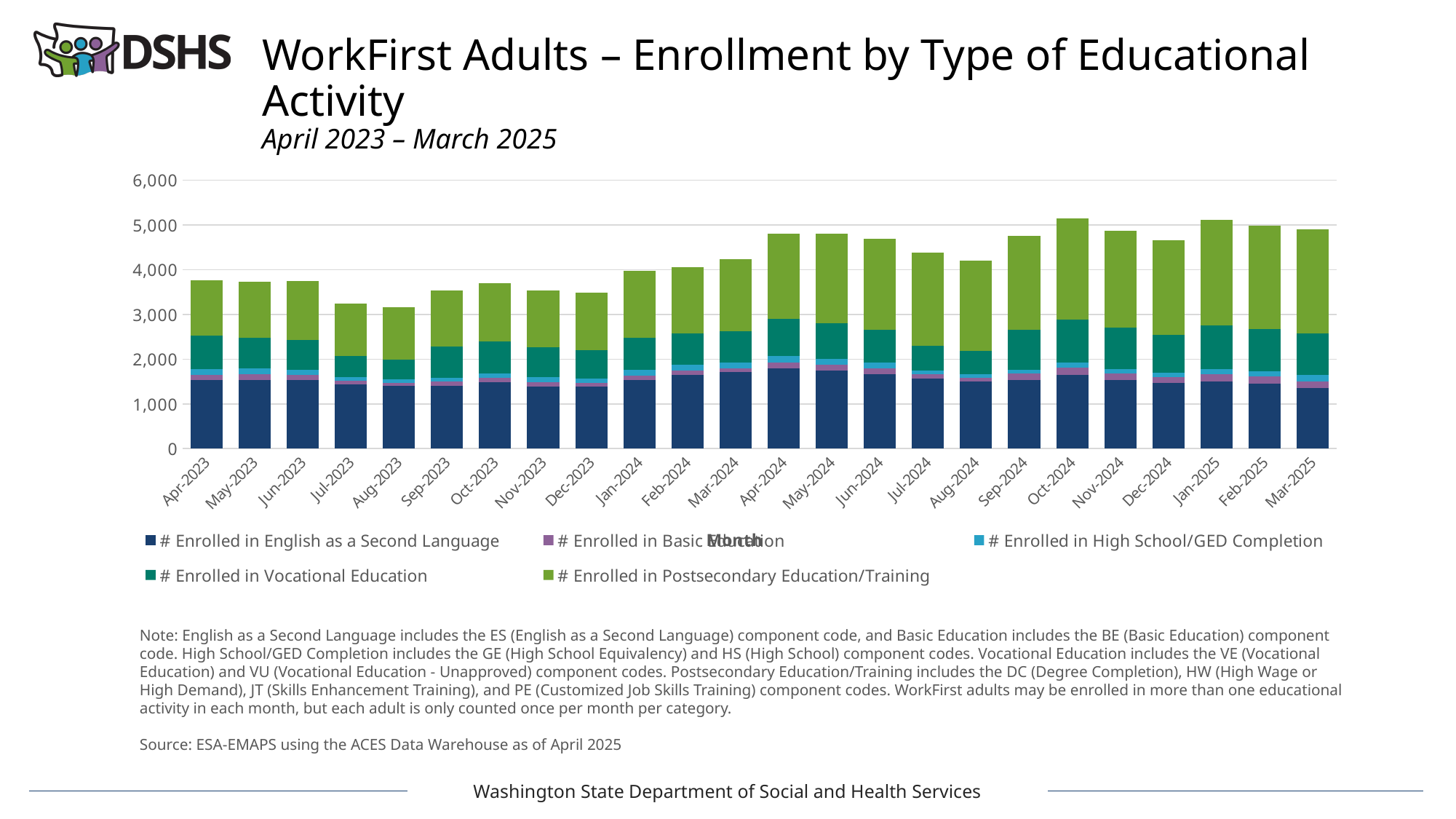
Is the total enrollment bar for Mar-2025 greater or less than 4,000? greater Which series forms the bottom segment of each stacked bar? # Enrolled in English as a Second Language Overall, do the total enrollment bars rise or fall from Apr-2023 to Mar-2025? rise Which month has the taller total enrollment bar, Apr-2024 or Aug-2024? Apr-2024 How many series does the chart's legend list? 5 Is the total enrollment bar for Aug-2023 greater or less than 4,000? less Is the total enrollment bar for Dec-2023 greater or less than 4,000? less What kind of chart is shown on the slide? Stacked bar chart What is the date range given in the chart's subtitle? April 2023 – March 2025 How many months are plotted along the x axis of the chart? 24 Which month has the lowest total enrollment bar in the chart? Aug-2023